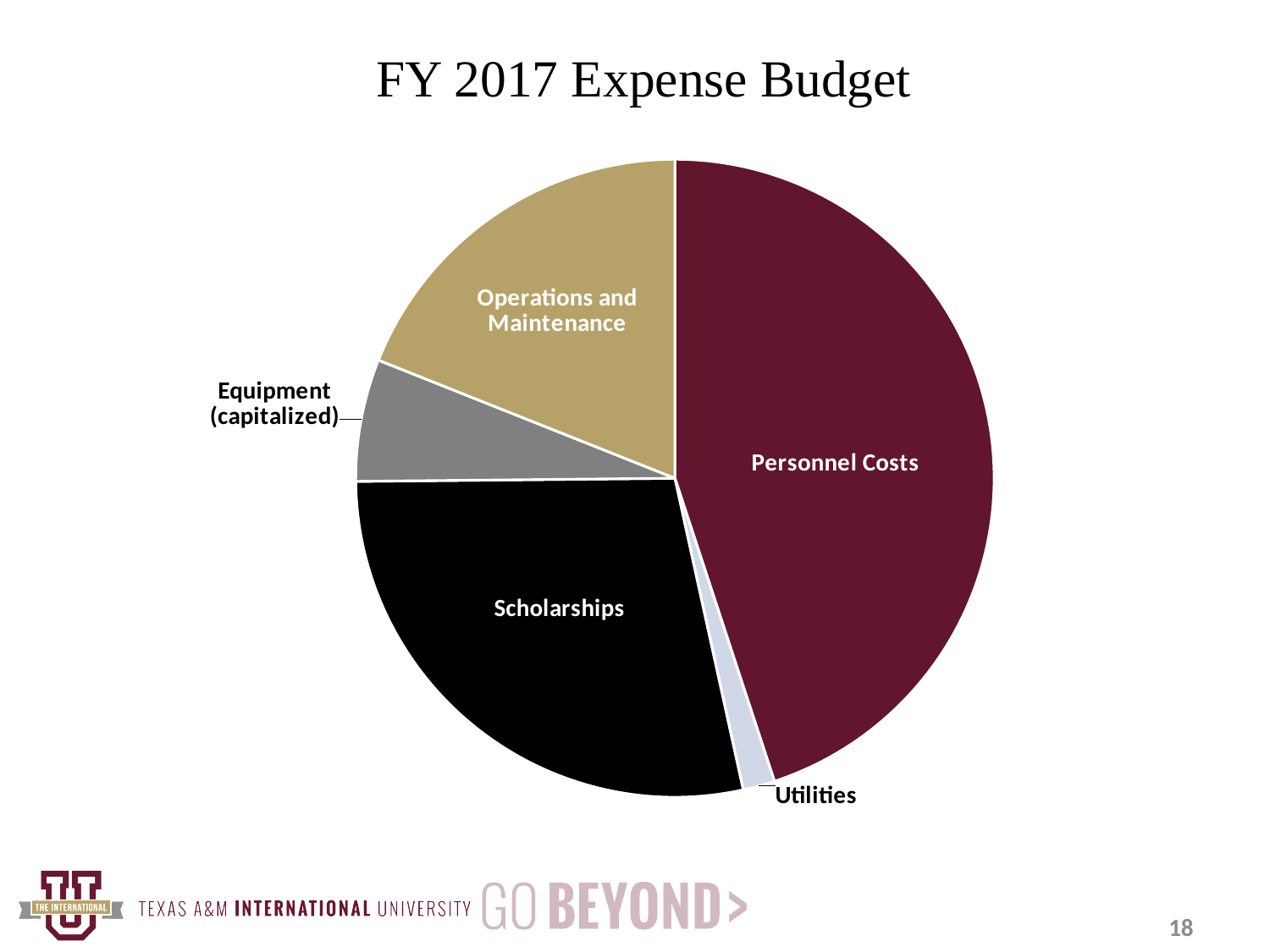
Which slice is larger, Personnel Costs or Scholarships? Personnel Costs Which slice is larger, Equipment (capitalized) or Utilities? Equipment (capitalized) Which slice is larger, Operations and Maintenance or Equipment (capitalized)? Operations and Maintenance Which expense category is shown in black on the pie chart? Scholarships How many slices does the pie chart have? 5 What is the title of the chart? FY 2017 Expense Budget Which expense category has the second-largest slice of the pie? Scholarships What kind of chart is shown on the slide? Pie chart Which expense category has the largest slice of the pie? Personnel Costs Which expense category has the smallest slice of the pie? Utilities